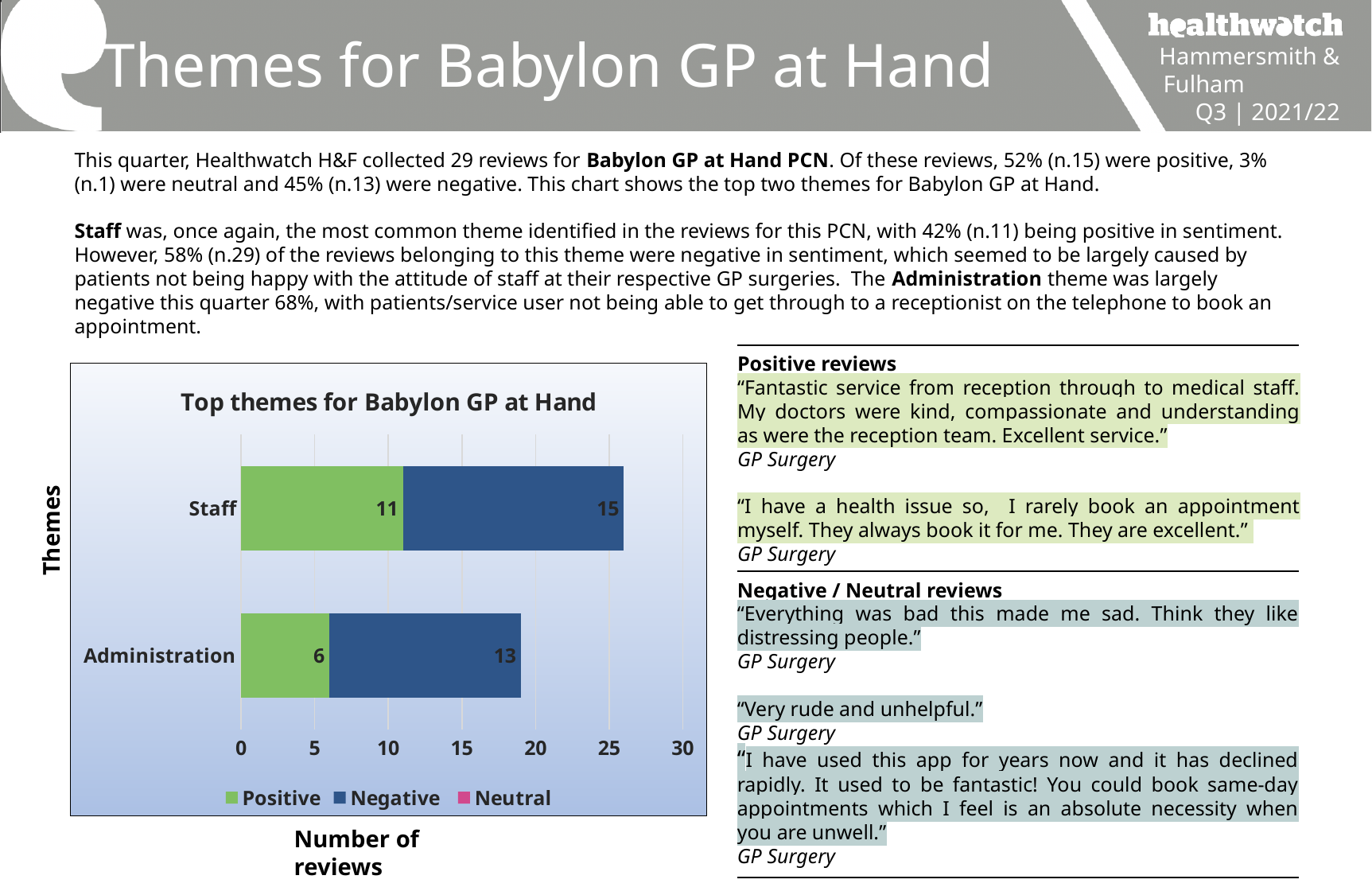
What is the total number of reviews shown for the Administration theme? 19 What is the number of Negative reviews for the Administration theme? 13 How many series does the chart legend list? 3 What type of chart is shown on the slide? Stacked bar chart What is the number of Positive reviews for the Administration theme? 6 How many themes are plotted on the chart? 2 What is the number of Negative reviews for the Staff theme? 15 What is the difference between the Negative reviews for Staff and the Negative reviews for Administration? 2 Which theme has more Positive reviews, Staff or Administration? Staff What is the number of Positive reviews for the Staff theme? 11 What is the title of the chart? Top themes for Babylon GP at Hand What is the total number of reviews shown for the Staff theme? 26